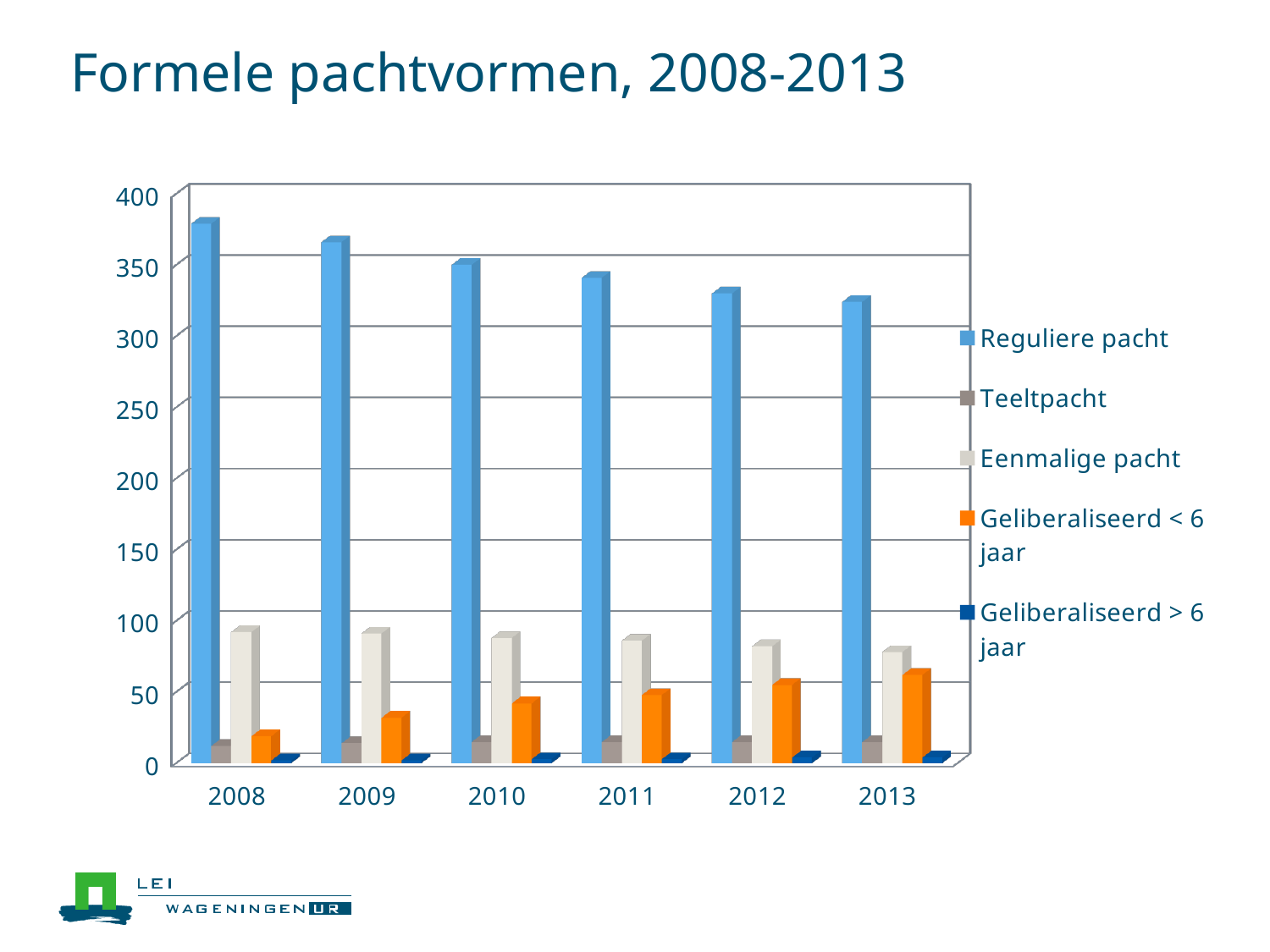
Does Reguliere pacht rise or fall from 2008 to 2013? Fall Is the value for Geliberaliseerd < 6 jaar in 2013 greater or less than 50? greater Is the value for Geliberaliseerd < 6 jaar in 2008 greater or less than 50? less In which year is Geliberaliseerd < 6 jaar lowest? 2008 Is the value for Reguliere pacht in 2013 greater or less than 350? less What kind of chart is shown on the slide? Bar chart How many years are shown on the x axis? 6 How many series does the legend list? 5 In which year is Reguliere pacht highest? 2008 In 2008, which is larger: Eenmalige pacht or Geliberaliseerd < 6 jaar? Eenmalige pacht What is the title of the chart? Formele pachtvormen, 2008-2013